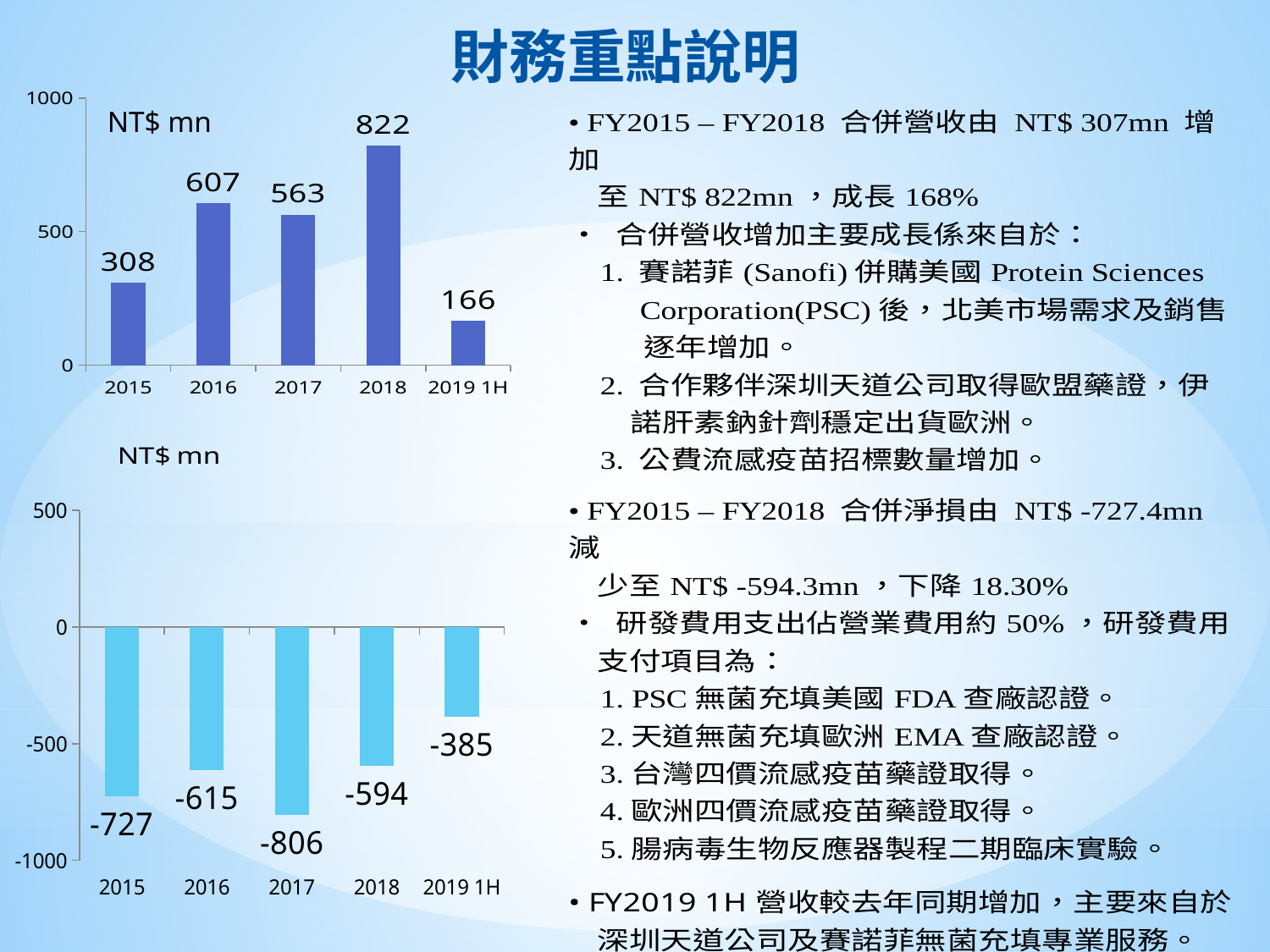
In the bottom chart, what is the value for 2017? -806 In the top chart, is the value for 2016 greater or less than 500? greater In the top chart, what is the difference between the values for 2018 and 2015? 514 In the bottom chart, what is the value for 2019 1H? -385 What unit label is shown on both charts? NT$ mn In the bottom chart, which year has the lowest value? 2017 In the top chart, what is the value for 2019 1H? 166 What kind of chart is the bottom chart? bar chart In the top chart, what is the value for 2018? 822 In the top chart, which year has the highest value? 2018 How many bars are in the top chart? 5 In the bottom chart, which is larger, the value for 2016 or the value for 2018? 2018